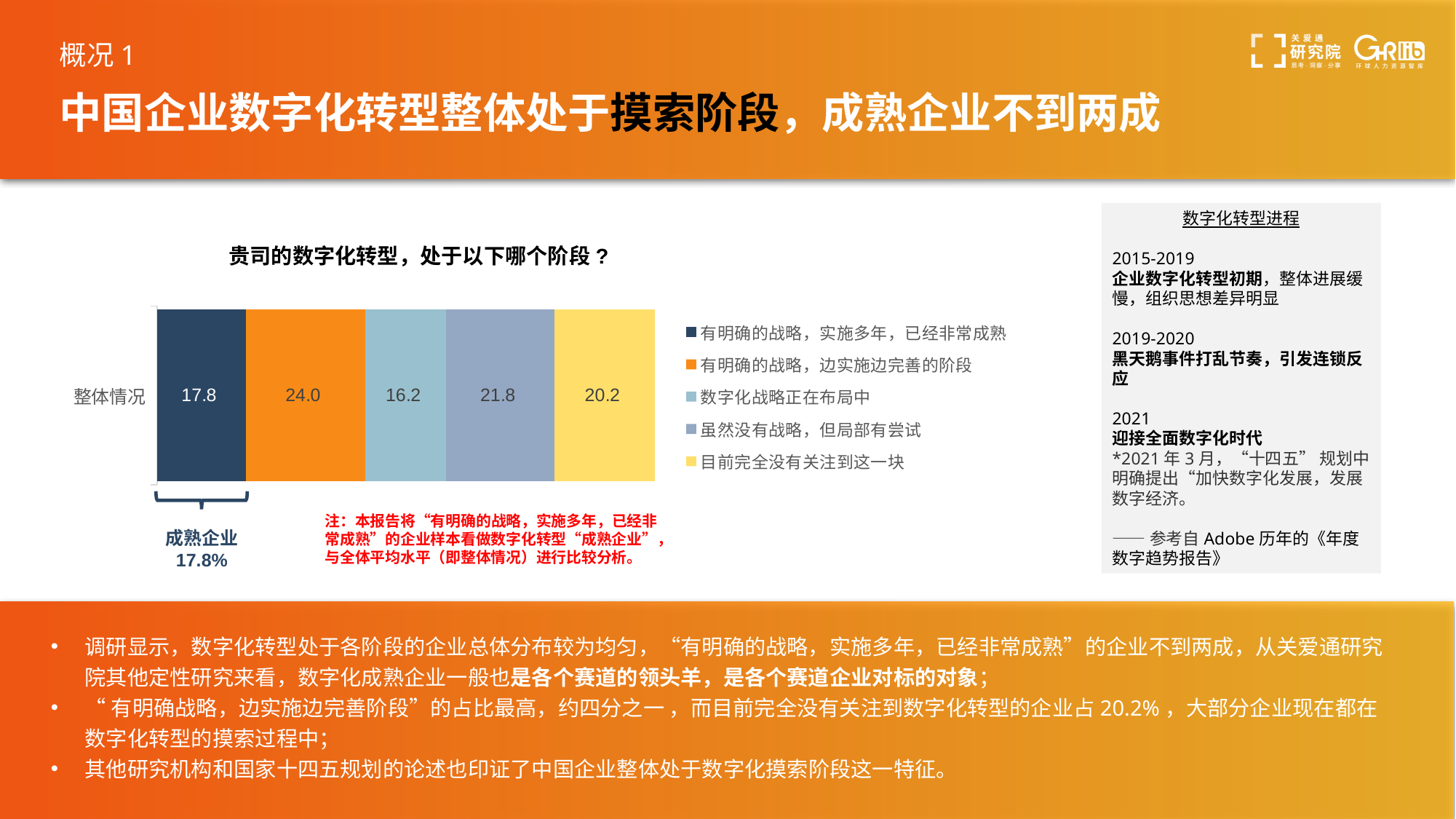
What is the value for the series "有明确的战略，实施多年，已经非常成熟" in the stacked bar? 17.8 What is the difference between the values for "有明确的战略，边实施边完善的阶段" and "有明确的战略，实施多年，已经非常成熟"? 6.2 Which series has the largest value in the stacked bar? 有明确的战略，边实施边完善的阶段 What is the value for the series "目前完全没有关注到这一块"? 20.2 How many series does the legend list? 5 What is the total of the stacked bar for "整体情况"? 100.0 What kind of chart is shown on the slide? Stacked bar chart What is the value for the series "有明确的战略，边实施边完善的阶段"? 24.0 Which series has the smallest value in the stacked bar? 数字化战略正在布局中 What is the title of the chart? 贵司的数字化转型，处于以下哪个阶段？ Which is larger: the value for "虽然没有战略，但局部有尝试" or the value for "目前完全没有关注到这一块"? 虽然没有战略，但局部有尝试 What is the value for the series "数字化战略正在布局中"? 16.2